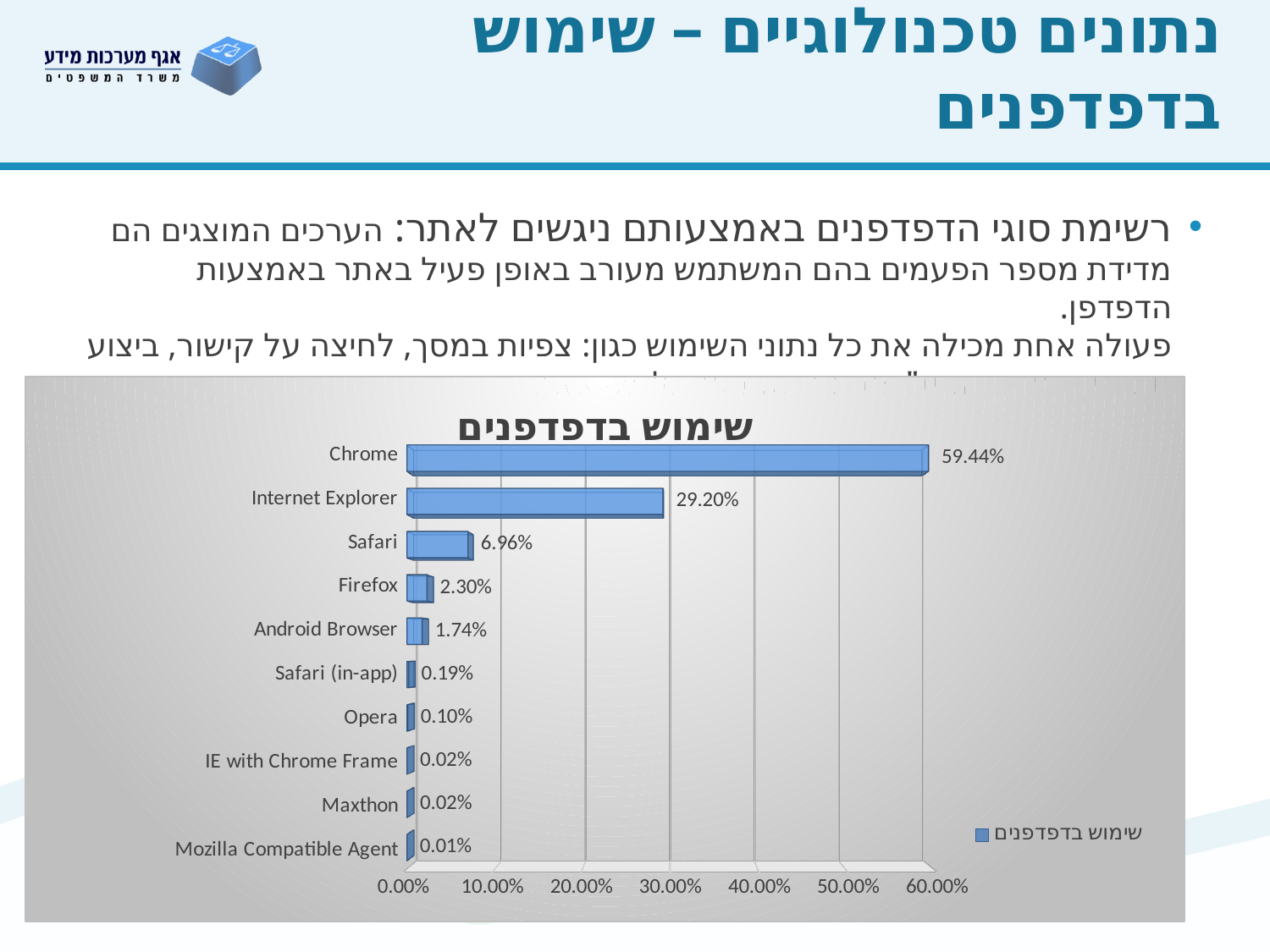
How many browsers are shown in the chart? 10 What is the value for Safari? 6.96% Which browser has the highest value? Chrome How many series does the legend list? 1 Is the value for Internet Explorer greater or less than 30.00%? less What is the value for Chrome? 59.44% What is the value for Android Browser? 1.74% What is the difference between the values for Chrome and Internet Explorer? 30.24% What kind of chart is shown on the slide? bar chart Which browser has the lowest value? Mozilla Compatible Agent Which is larger, the value for Firefox or the value for Android Browser? Firefox What is the value for Internet Explorer? 29.20%